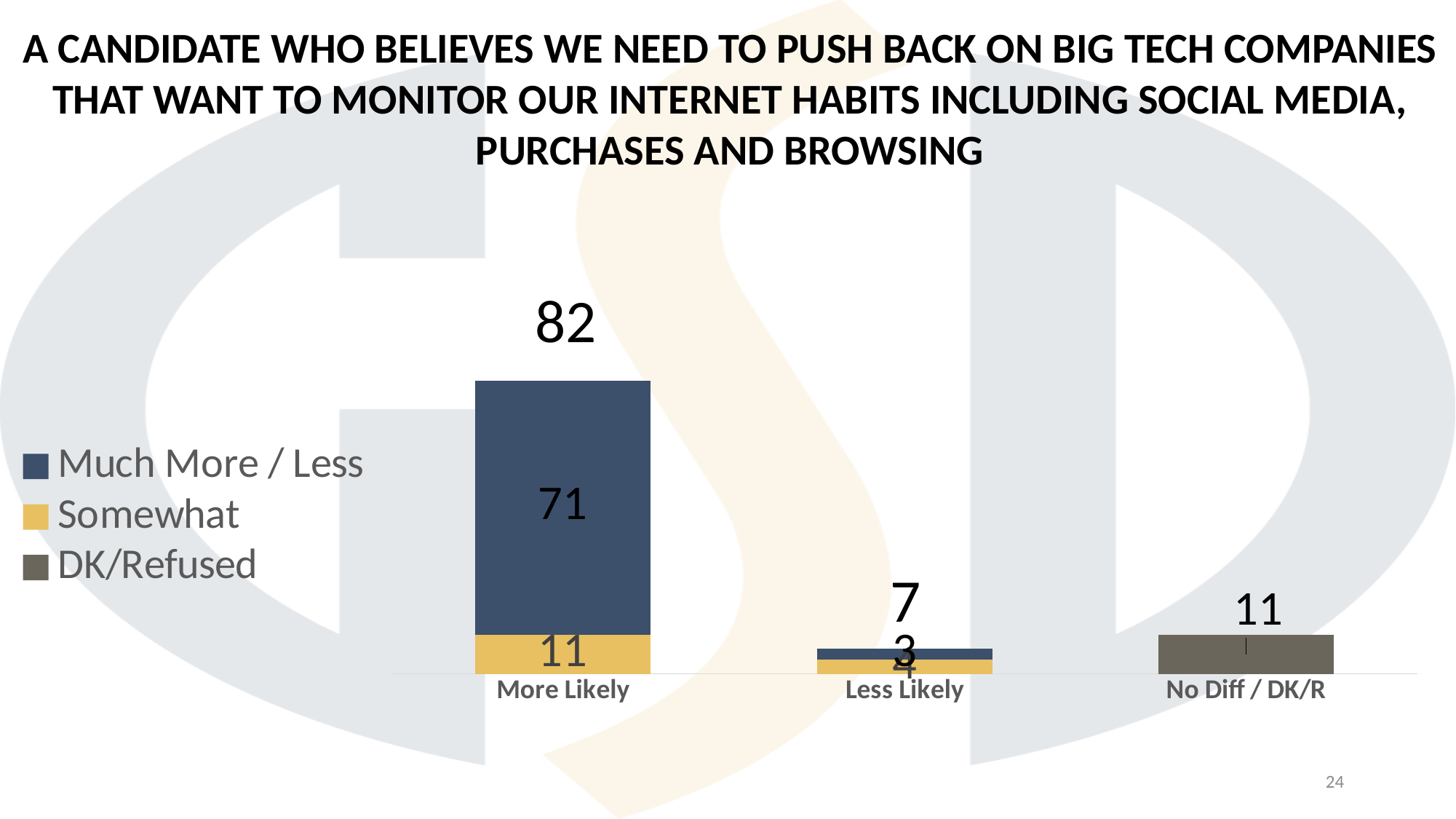
What is the Much More / Less value for the More Likely category? 71 What is the difference between the More Likely total and the Less Likely total? 75 What type of chart is shown on the slide? Stacked bar chart Which category has the highest total value? More Likely What is the total value shown above the More Likely bar? 82 How many series does the chart's legend list? 3 What is the total value shown above the Less Likely bar? 7 What is the Somewhat value for the More Likely category? 11 What is the value for the No Diff / DK/R category? 11 What is the Much More / Less value for the Less Likely category? 3 How many categories are shown on the x axis of the chart? 3 Which category has the lowest total value? Less Likely